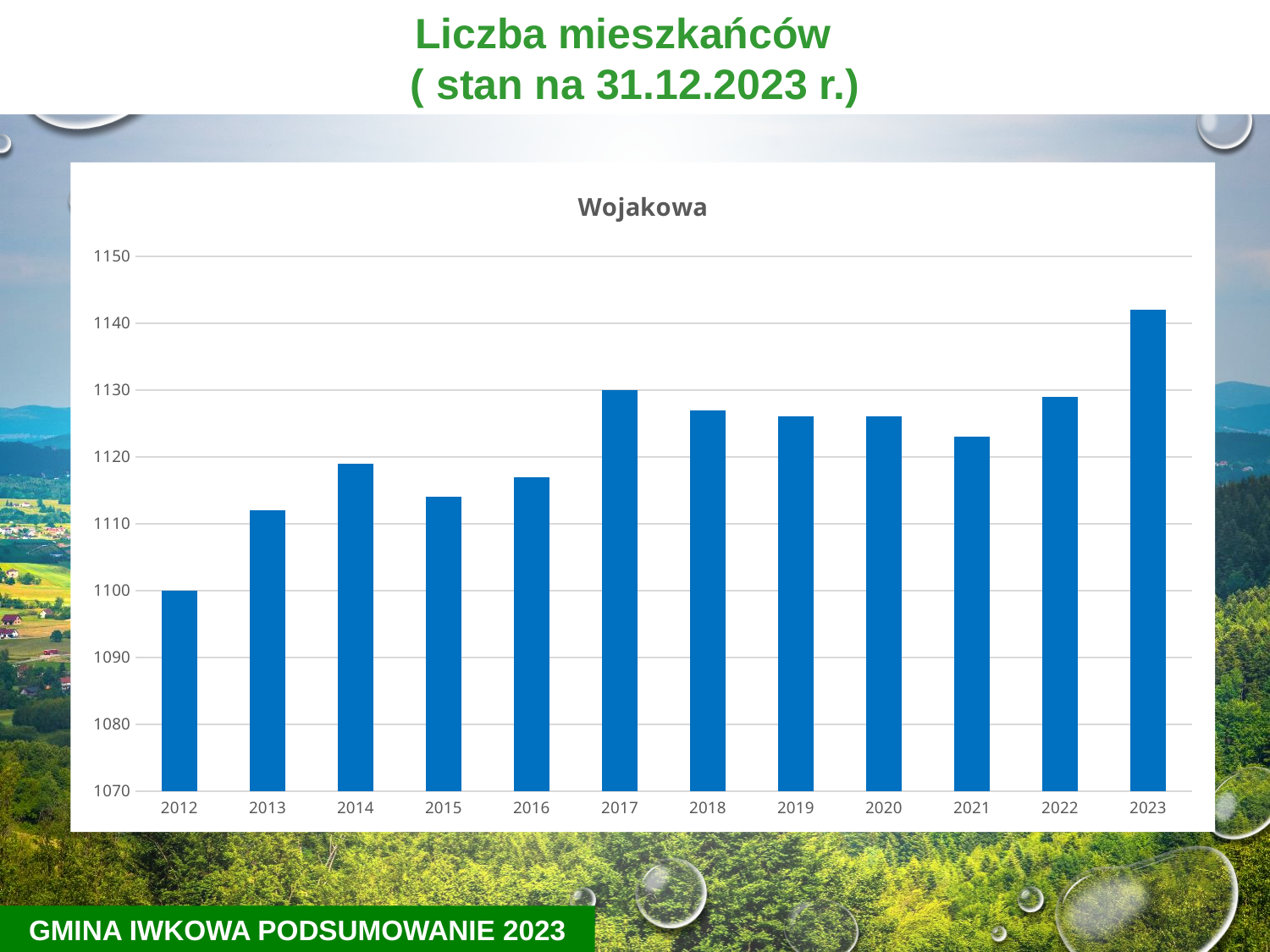
Is the value for 2023 greater or less than 1140? greater Is the value for 2015 greater or less than 1120? less What kind of chart is shown on the slide? bar chart What is the value for 2017 in the chart? 1130 What is the difference between the values for 2017 and 2012? 30 Which is larger, the value for 2014 or the value for 2015? 2014 What is the value for 2012 in the chart? 1100 Which year has the lowest number of residents in the chart? 2012 What is the title of the chart? Wojakowa Which year has the highest number of residents in the chart? 2023 How many years are shown on the x axis of the chart? 12 Overall, do the values rise or fall from 2012 to 2023? rise